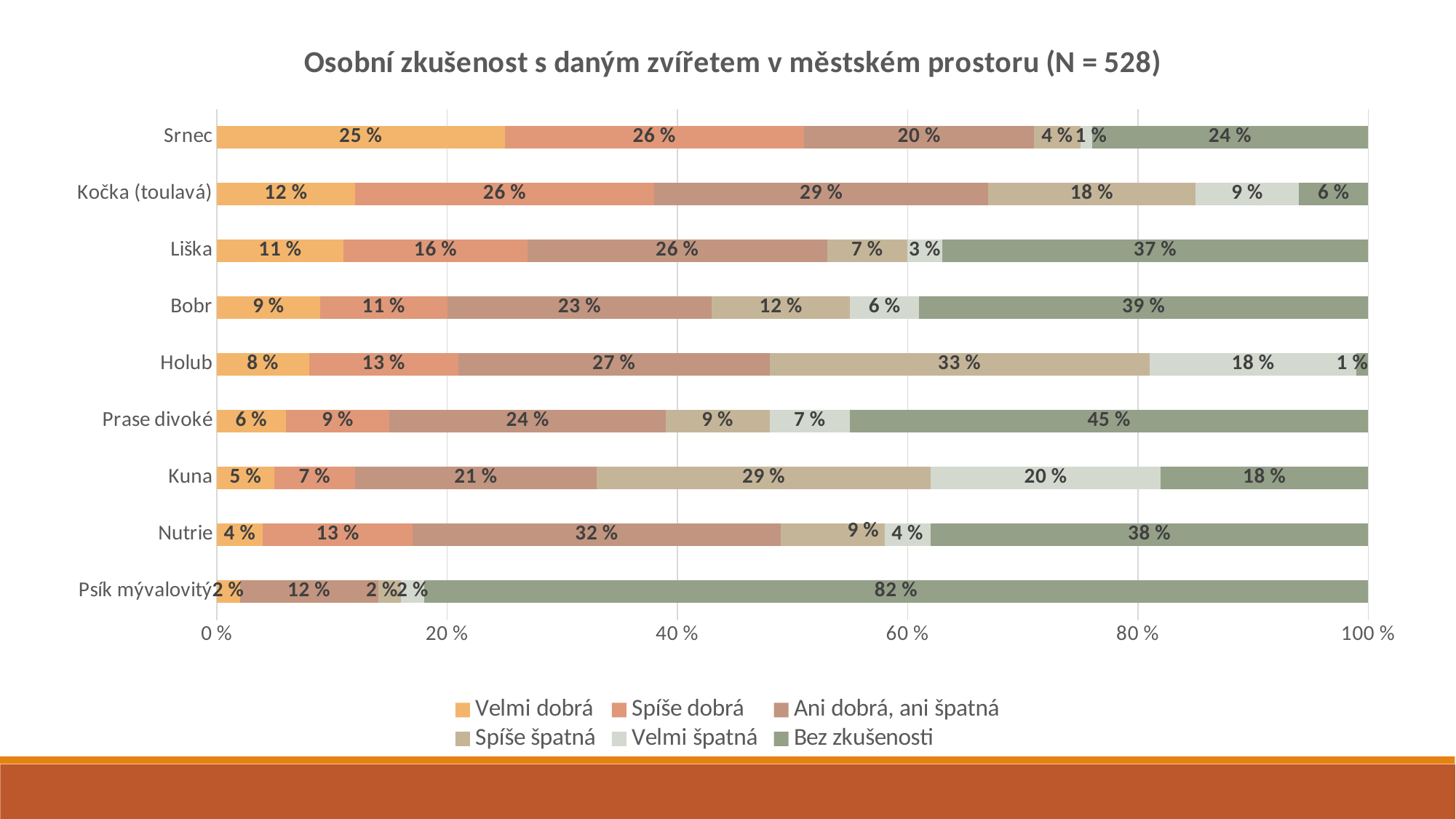
Which has a larger "Spíše špatná" value, Kuna or Bobr? Kuna What is the value of "Velmi dobrá" for Srnec? 25 % How many categories (animals) are shown on the chart? 9 What is the value of "Bez zkušenosti" for Prase divoké? 45 % What is the title of the chart? Osobní zkušenost s daným zvířetem v městském prostoru (N = 528) What is the difference between the "Velmi dobrá" values for Srnec and Kočka (toulavá)? 13 % What kind of chart is shown on the slide? Stacked bar chart Which category has the highest value for "Velmi dobrá"? Srnec What is the value of "Spíše špatná" for Holub? 33 % Which category has the lowest value for "Bez zkušenosti"? Holub How many series does the legend list? 6 Which category has the highest value for "Bez zkušenosti"? Psík mývalovitý